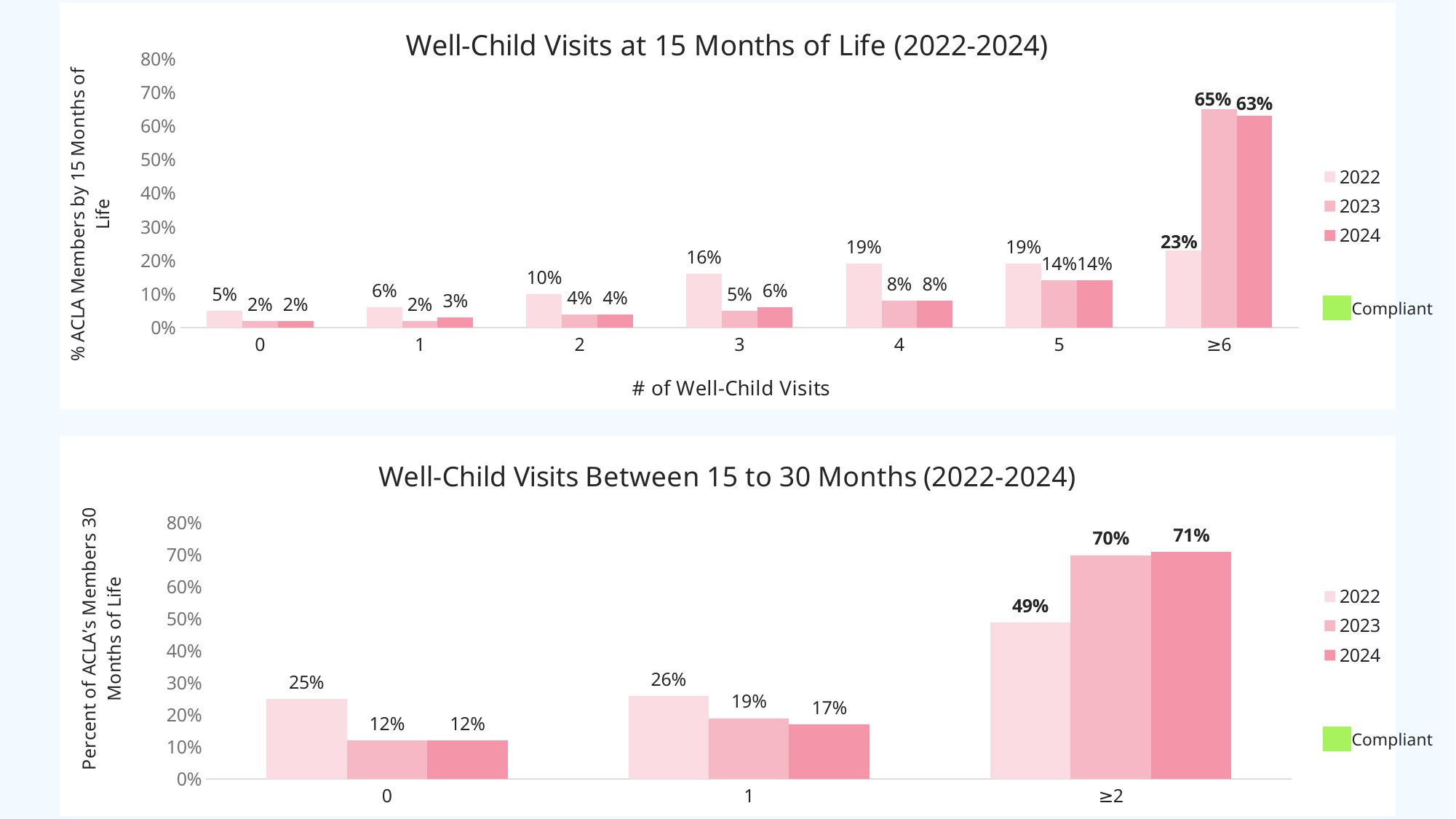
What type of chart is the 'Well-Child Visits Between 15 to 30 Months (2022-2024)' chart? Bar chart In the 'Well-Child Visits Between 15 to 30 Months (2022-2024)' chart, which is larger for 0 visits: the 2022 value or the 2023 value? 2022 In the 'Well-Child Visits Between 15 to 30 Months (2022-2024)' chart, what is the 2024 value for ≥2 visits? 71% In the 'Well-Child Visits Between 15 to 30 Months (2022-2024)' chart, how do the 2024 values change from 0 visits to ≥2 visits? They rise In the 'Well-Child Visits Between 15 to 30 Months (2022-2024)' chart, what is the difference between the 2023 and 2022 values for ≥2 visits? 21% In the 'Well-Child Visits at 15 Months of Life (2022-2024)' chart, what is the 2022 value for 3 visits? 16% In the 'Well-Child Visits Between 15 to 30 Months (2022-2024)' chart, what is the 2022 value for 1 visit? 26% In the 'Well-Child Visits at 15 Months of Life (2022-2024)' chart, which number of visits has the highest 2024 value? ≥6 In the 'Well-Child Visits at 15 Months of Life (2022-2024)' chart, how many series does the legend list (excluding the Compliant marker)? 3 In the 'Well-Child Visits at 15 Months of Life (2022-2024)' chart, what is the difference between the 2023 and 2022 values for ≥6 visits? 42% In the 'Well-Child Visits at 15 Months of Life (2022-2024)' chart, what is the 2023 value for ≥6 visits? 65% In the 'Well-Child Visits at 15 Months of Life (2022-2024)' chart, how many categories are shown on the x axis? 7